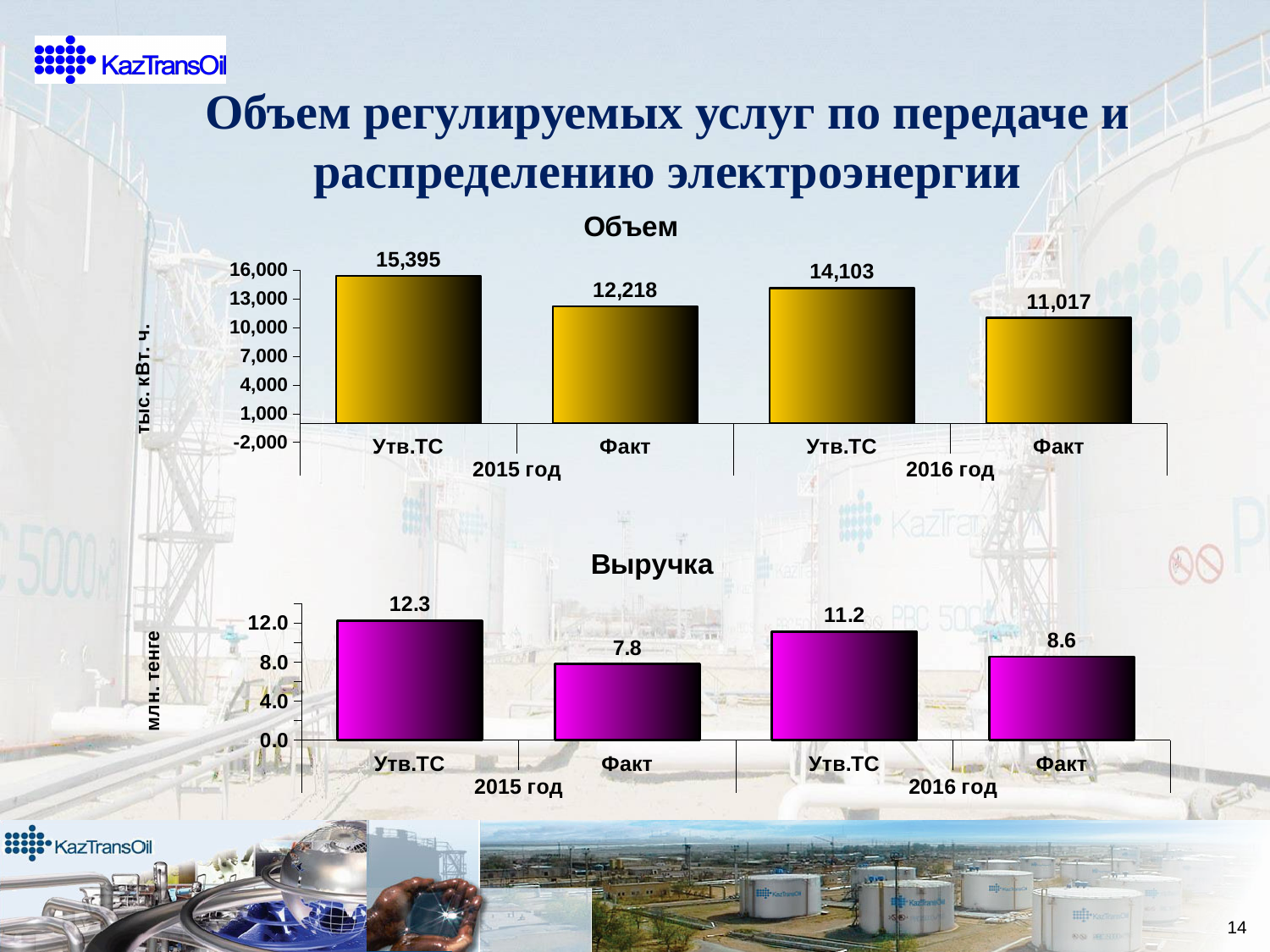
What type of chart is the "Выручка" chart? Bar chart In the "Выручка" chart, what is the value for Утв.ТС in 2016 год? 11.2 In the "Выручка" chart, what is the difference between Утв.ТС and Факт for 2016 год? 2.6 In the "Объем" chart, what is the difference between Утв.ТС and Факт for 2015 год? 3,177 In the "Объем" chart, what unit is shown on the vertical axis? тыс. кВт. ч. In the "Объем" chart, how many bars are plotted? 4 In the "Выручка" chart, which bar is the highest? Утв.ТС 2015 год In the "Выручка" chart, what is the value for Факт in 2015 год? 7.8 In the "Объем" chart, which bar is the lowest? Факт 2016 год In the "Объем" chart, what is the value for Факт in 2016 год? 11,017 In the "Выручка" chart, which is larger: Факт in 2015 год or Факт in 2016 год? Факт 2016 год In the "Объем" chart, what is the value for Утв.ТС in 2015 год? 15,395